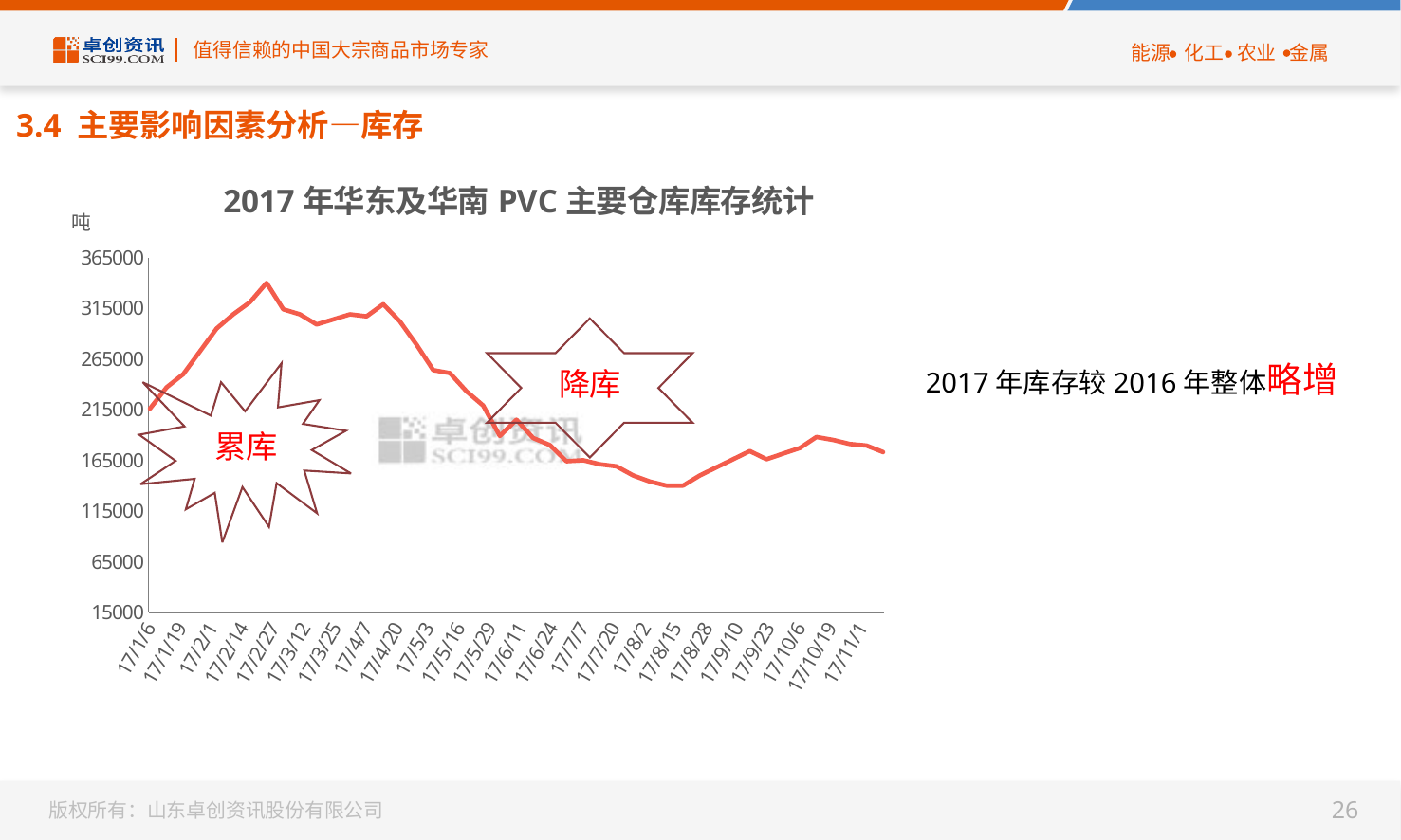
Is the value at 17/11/1 greater or less than 215000? less What kind of chart is shown on the slide? Line chart Which is larger, the value at 17/2/27 or the value at 17/8/15? 17/2/27 Is the value at 17/2/27 greater or less than 315000? greater What unit is shown on the y axis of the chart? 吨 Does the inventory line rise or fall between 17/1/6 and 17/2/27? Rise Is the value at 17/1/6 greater or less than 265000? less What is the title of the chart? 2017 年华东及华南 PVC 主要仓库库存统计 Around which x-axis date does the inventory line reach its lowest point? 17/8/15 Around which x-axis date does the inventory line reach its highest point? 17/2/27 Does the inventory line rise or fall between 17/4/7 and 17/8/15? Fall